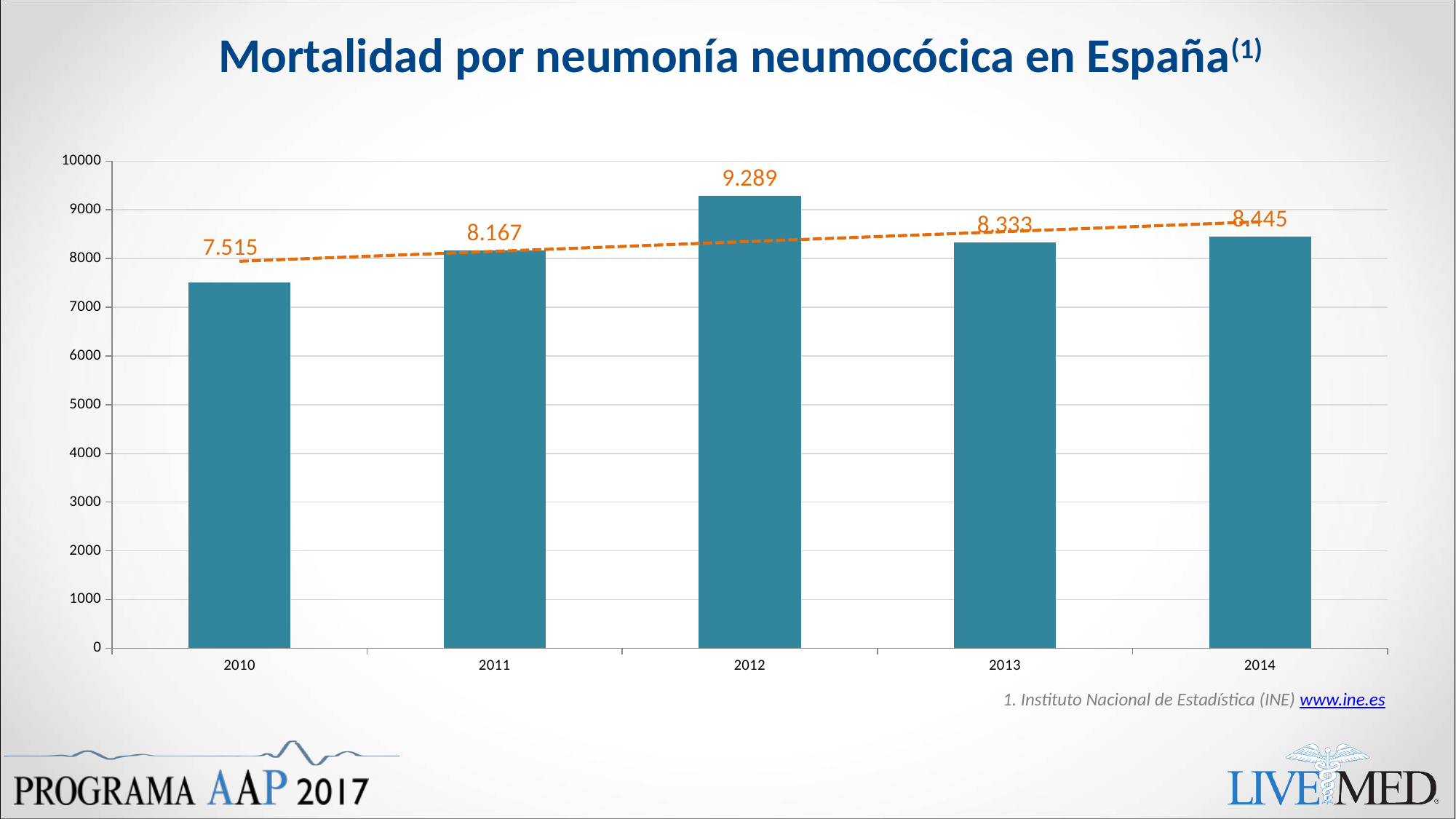
What kind of chart is this? bar chart What is the value shown for 2012? 9.289 Is the value for 2010 greater or less than 8000? less Does the dashed orange trend line rise or fall from 2010 to 2014? rises Which year has the lowest value? 2010 What is the difference between the values for 2014 and 2013? 112 How many years are shown on the x axis? 5 What is the difference between the values for 2012 and 2010? 1.774 What is the value shown for 2014? 8.445 Which is larger, the value for 2011 or the value for 2013? 2013 What is the value shown for 2010? 7.515 Which year has the highest value? 2012